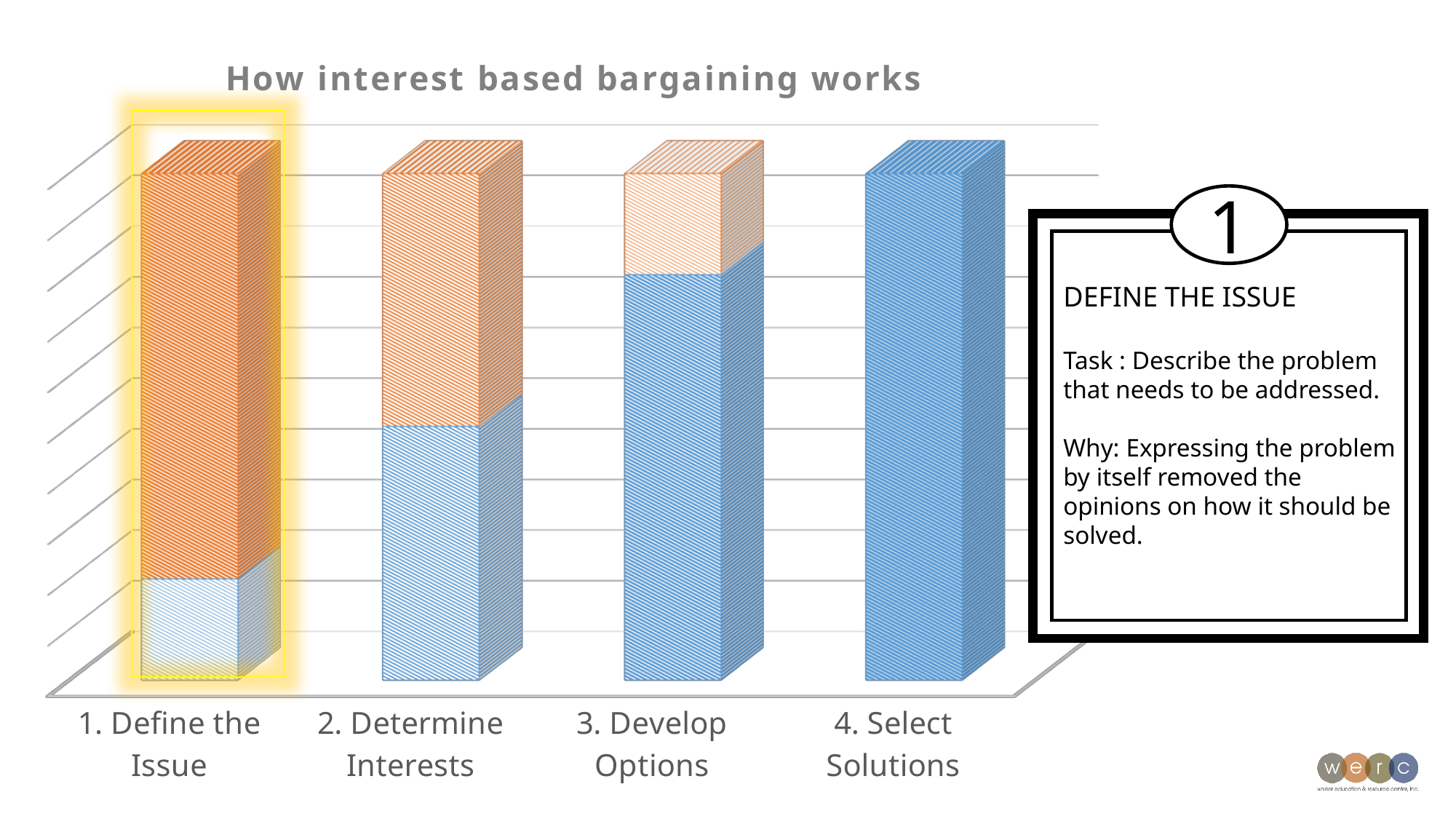
What is the label of the first category on the x axis? 1. Define the Issue What kind of chart is shown on the slide? Stacked bar chart What is the title of the chart? How interest based bargaining works Which has the larger orange segment, 2. Determine Interests or 3. Develop Options? 2. Determine Interests Does the blue segment rise or fall moving from left to right across the categories? Rise Which category has the largest blue segment? 4. Select Solutions Which category has the smallest orange segment? 4. Select Solutions Which has the larger blue segment, 2. Determine Interests or 3. Develop Options? 3. Develop Options How many categories are shown along the x axis of the chart? 4 Does the orange segment rise or fall moving from left to right across the categories? Fall Which category has the smallest blue segment? 1. Define the Issue Which category has the largest orange segment? 1. Define the Issue